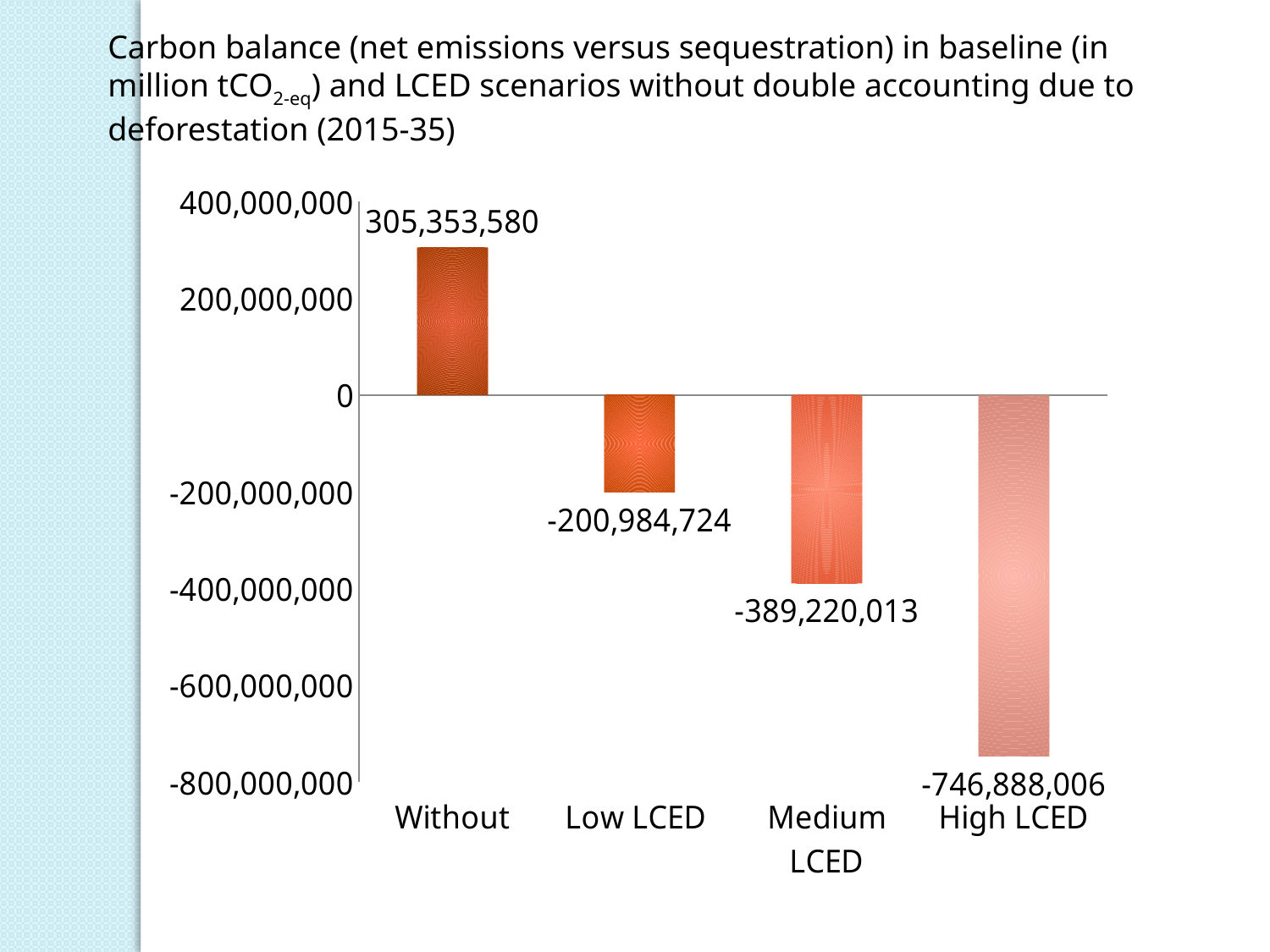
What kind of chart is shown on the slide? Bar chart Which is larger, the value for Low LCED or the value for Medium LCED? Low LCED Which scenario has the lowest carbon balance value? High LCED Do the values rise or fall moving from Without to High LCED along the x axis? Fall Which scenario has the highest carbon balance value? Without What is the difference between the Medium LCED value and the High LCED value? 357,667,993 What is the difference between the Without value and the Low LCED value? 506,338,304 What is the carbon balance value for the Medium LCED scenario? -389,220,013 How many scenarios are shown on the chart? 4 What is the carbon balance value for the Low LCED scenario? -200,984,724 What is the carbon balance value for the High LCED scenario? -746,888,006 What is the carbon balance value for the Without scenario? 305,353,580